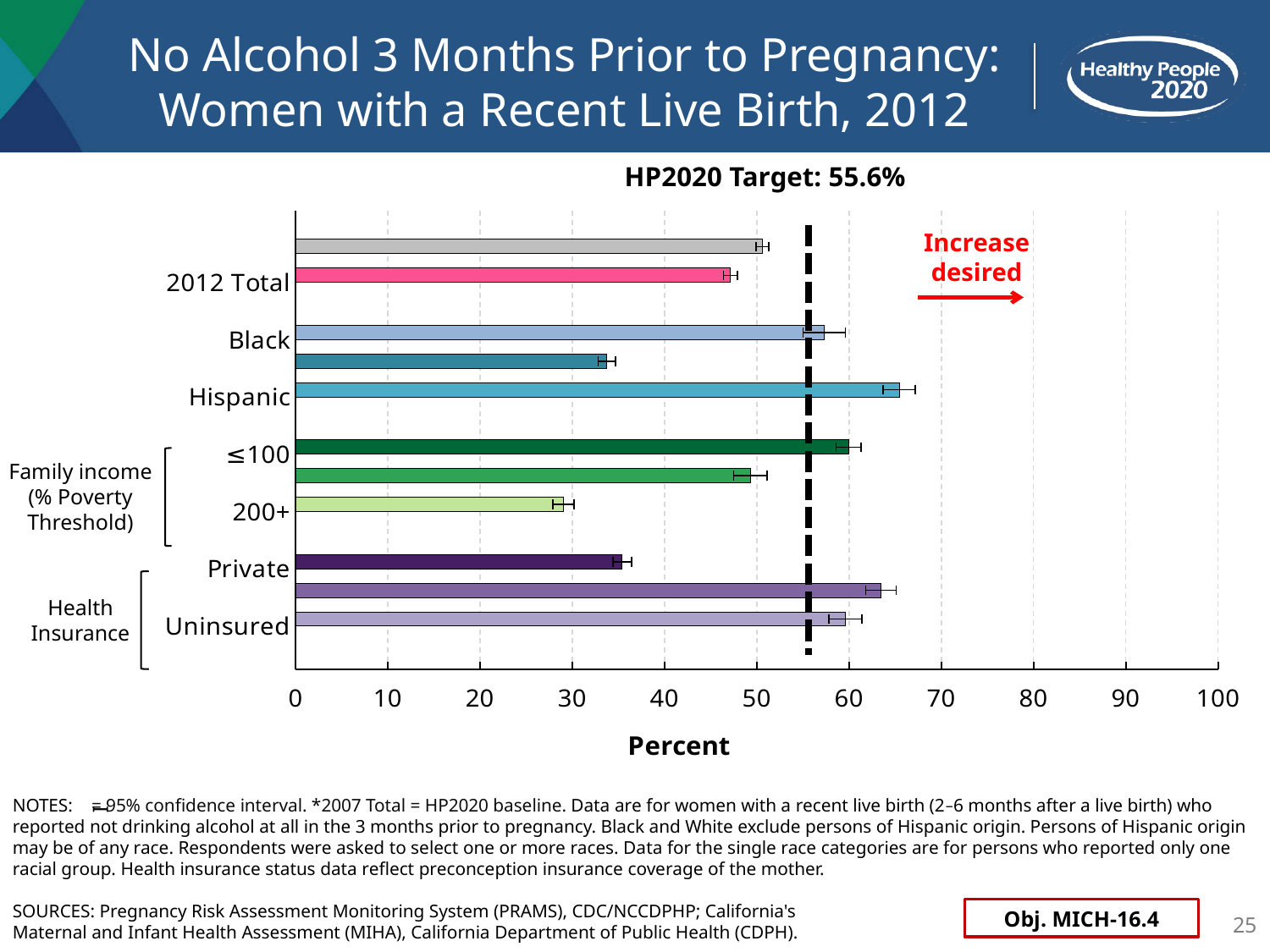
Which labeled category has the lowest value on the chart? 200+ Is the value for Private health insurance greater or less than 40? less Is the value for the 200+ family income group greater or less than 40? less Is the value for 2012 Total greater or less than 50? less What kind of chart is shown on the slide? bar chart Which has the larger value, Private or Uninsured? Uninsured What is the title of the x axis? Percent What is the HP2020 Target value shown on the slide? 55.6% Which has the larger value, Hispanic or Black? Hispanic